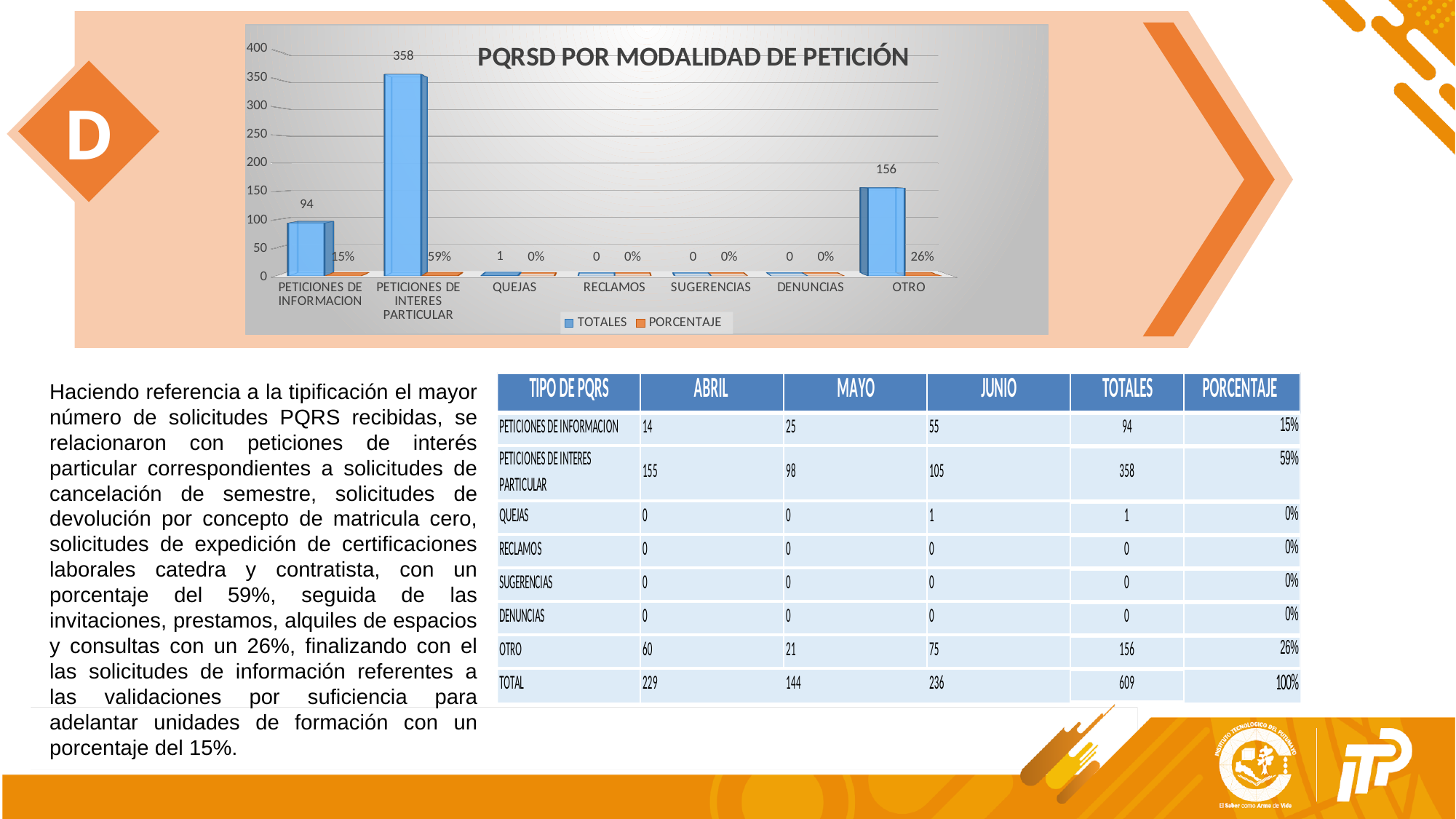
Which has a larger TOTALES value, PETICIONES DE INFORMACION or OTRO? OTRO How many series does the chart legend list? 2 What is the title of the chart? PQRSD POR MODALIDAD DE PETICIÓN What is the TOTALES value for OTRO? 156 How many categories are shown on the x axis of the chart? 7 What PORCENTAJE is shown for PETICIONES DE INFORMACION? 15% What is the difference in TOTALES between PETICIONES DE INTERES PARTICULAR and OTRO? 202 Is the TOTALES value for PETICIONES DE INTERES PARTICULAR greater or less than 300? greater What is the TOTALES value for PETICIONES DE INTERES PARTICULAR? 358 What type of chart is shown on the slide? Bar chart Which category has the highest TOTALES value? PETICIONES DE INTERES PARTICULAR What is the TOTALES value for QUEJAS? 1